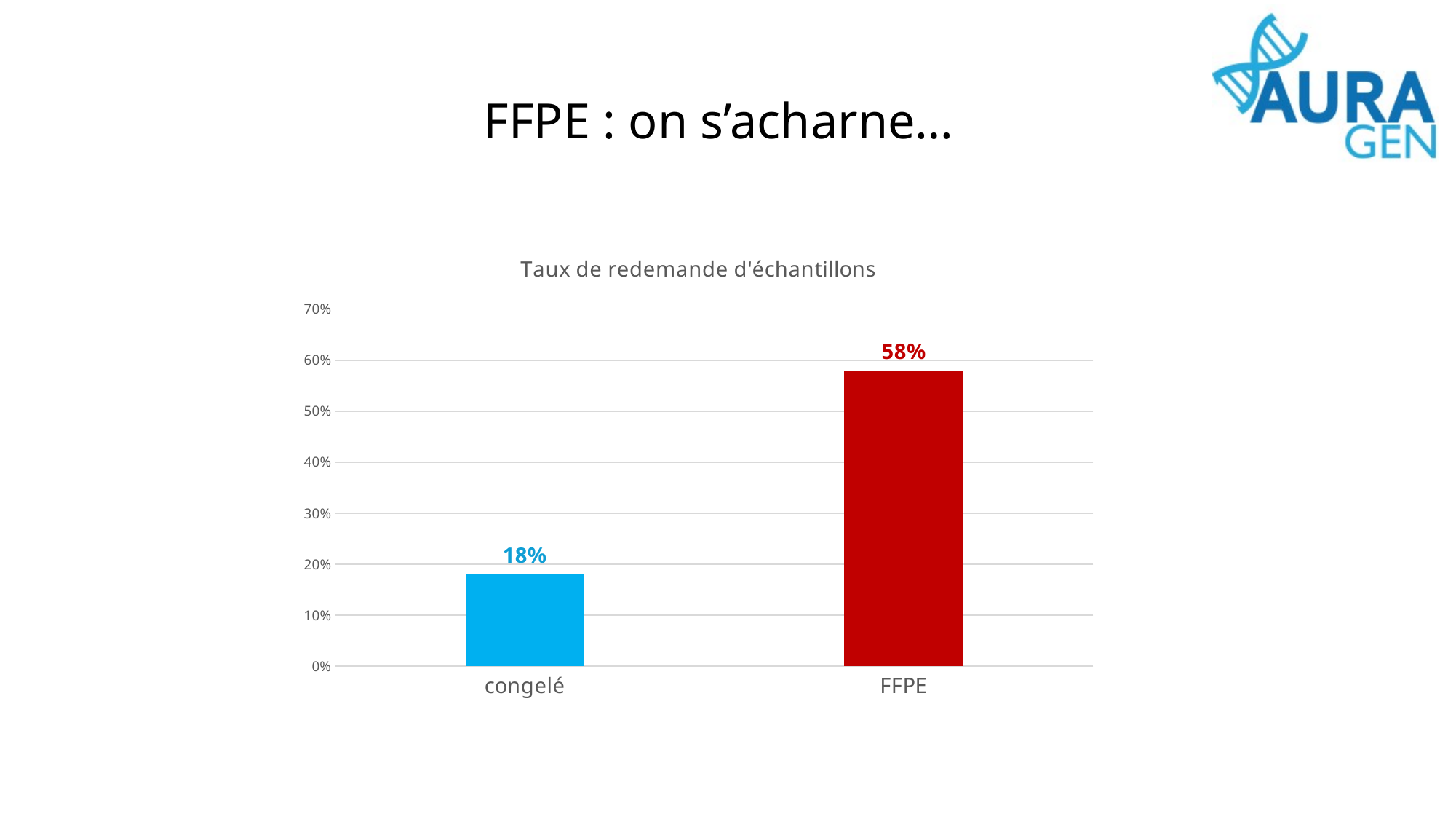
What colour is the bar for FFPE? red What kind of chart is shown on the slide? bar chart Is the value for congelé greater or less than 20%? less Is the value for FFPE greater or less than 50%? greater How many categories are shown in the chart? 2 Which category has the highest value? FFPE What is the value for FFPE? 58% What is the difference between the values for FFPE and congelé? 40% What is the title of the chart? Taux de redemande d'échantillons Which is larger, the value for congelé or the value for FFPE? FFPE What is the value for congelé? 18% Which category has the lowest value? congelé